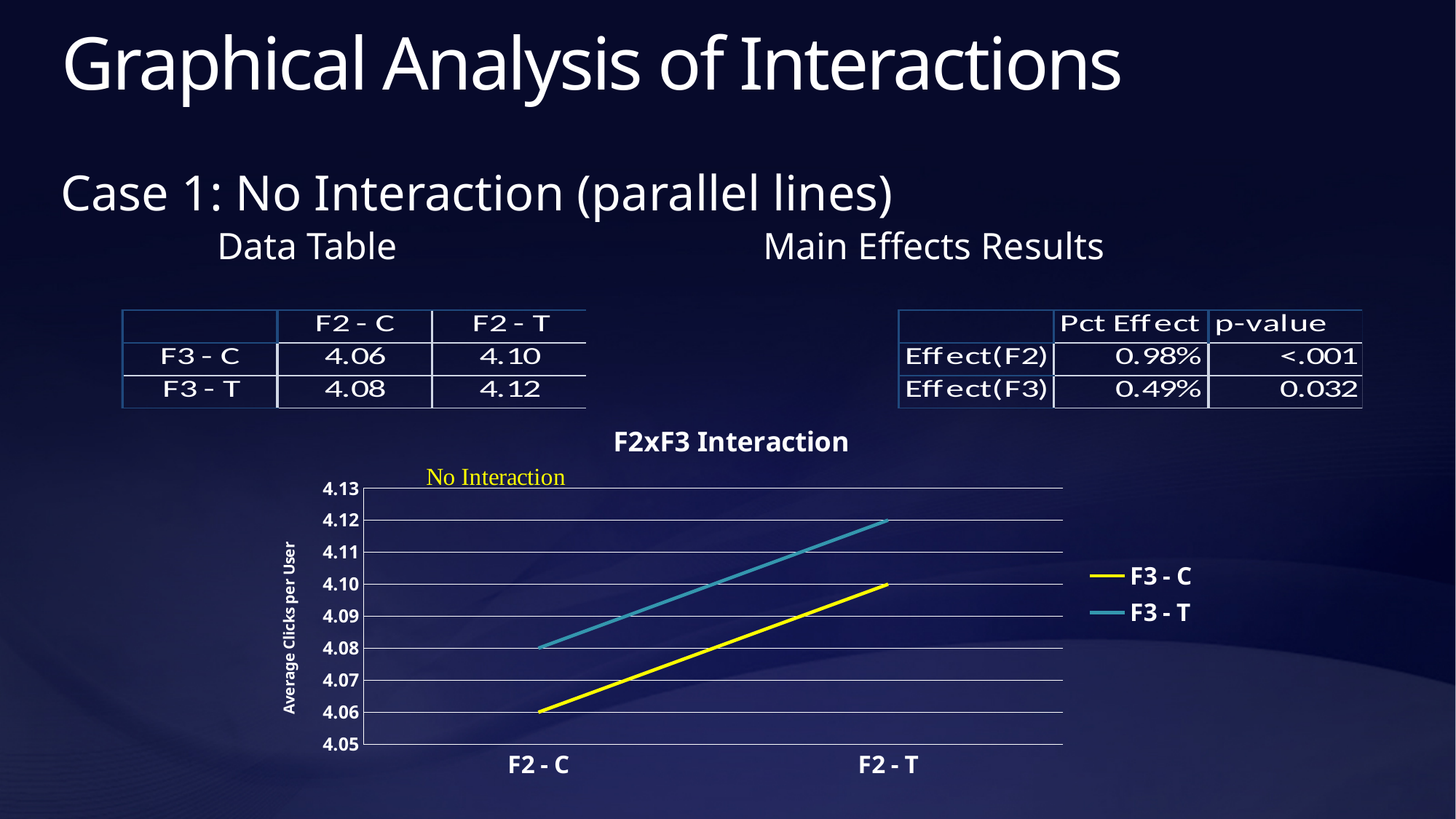
In the F2xF3 Interaction chart, what is the value of the F3 - C series at F2 - T? 4.10 In the F2xF3 Interaction chart, do the values of the F3 - C series rise or fall from F2 - C to F2 - T? rise In the F2xF3 Interaction chart, what is the value of the F3 - C series at F2 - C? 4.06 What is the y-axis label of the F2xF3 Interaction chart? Average Clicks per User What kind of chart is the F2xF3 Interaction chart? line chart How many categories are on the x axis of the F2xF3 Interaction chart? 2 In the F2xF3 Interaction chart, what is the value of the F3 - T series at F2 - T? 4.12 How many series does the legend of the F2xF3 Interaction chart list? 2 In the F2xF3 Interaction chart, what is the difference between the F3 - T and F3 - C values at F2 - C? 0.02 In the F2xF3 Interaction chart, which series has the higher value at F2 - T? F3 - T In the F2xF3 Interaction chart, what is the value of the F3 - T series at F2 - C? 4.08 In the F2xF3 Interaction chart, is the value of the F3 - T series at F2 - C greater or less than 4.10? less